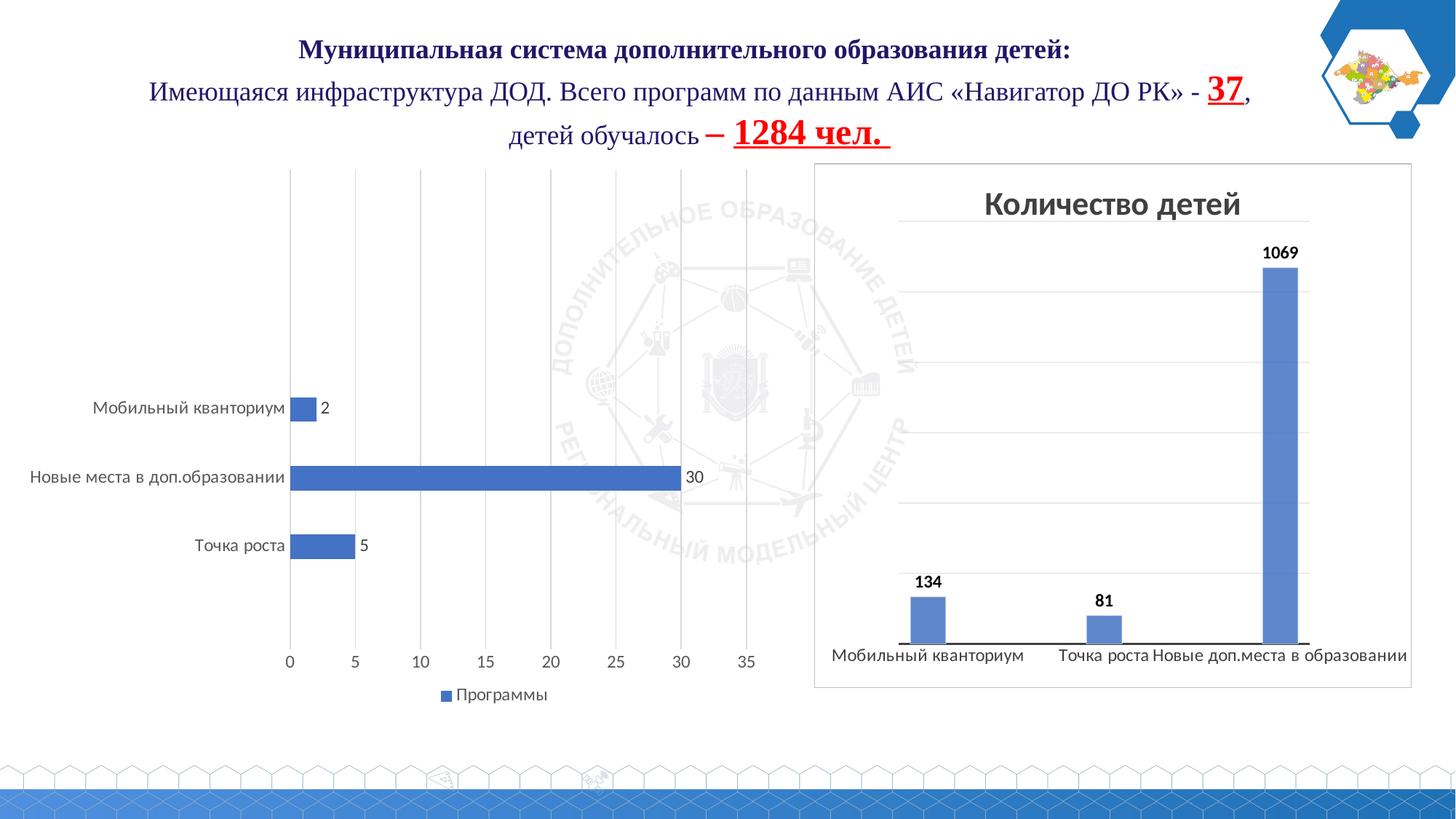
In the left chart (Программы), which category has the lowest value? Мобильный кванториум In the chart titled Количество детей, what is the difference between Мобильный кванториум and Точка роста? 53 In the left chart (Программы), what is the value for Новые места в доп.образовании? 30 In the chart titled Количество детей, what is the value for Новые доп.места в образовании? 1069 In the chart titled Количество детей, which category has the highest value? Новые доп.места в образовании In the left chart (Программы), how many series does the legend list? 1 In the left chart (Программы), what is the difference between Новые места в доп.образовании and Точка роста? 25 In the left chart (Программы), what kind of chart is shown? Bar chart In the chart titled Количество детей, which is larger: Мобильный кванториум or Точка роста? Мобильный кванториум In the left chart (Программы), what is the value for Мобильный кванториум? 2 In the chart titled Количество детей, how many categories are shown? 3 In the chart titled Количество детей, what is the value for Точка роста? 81